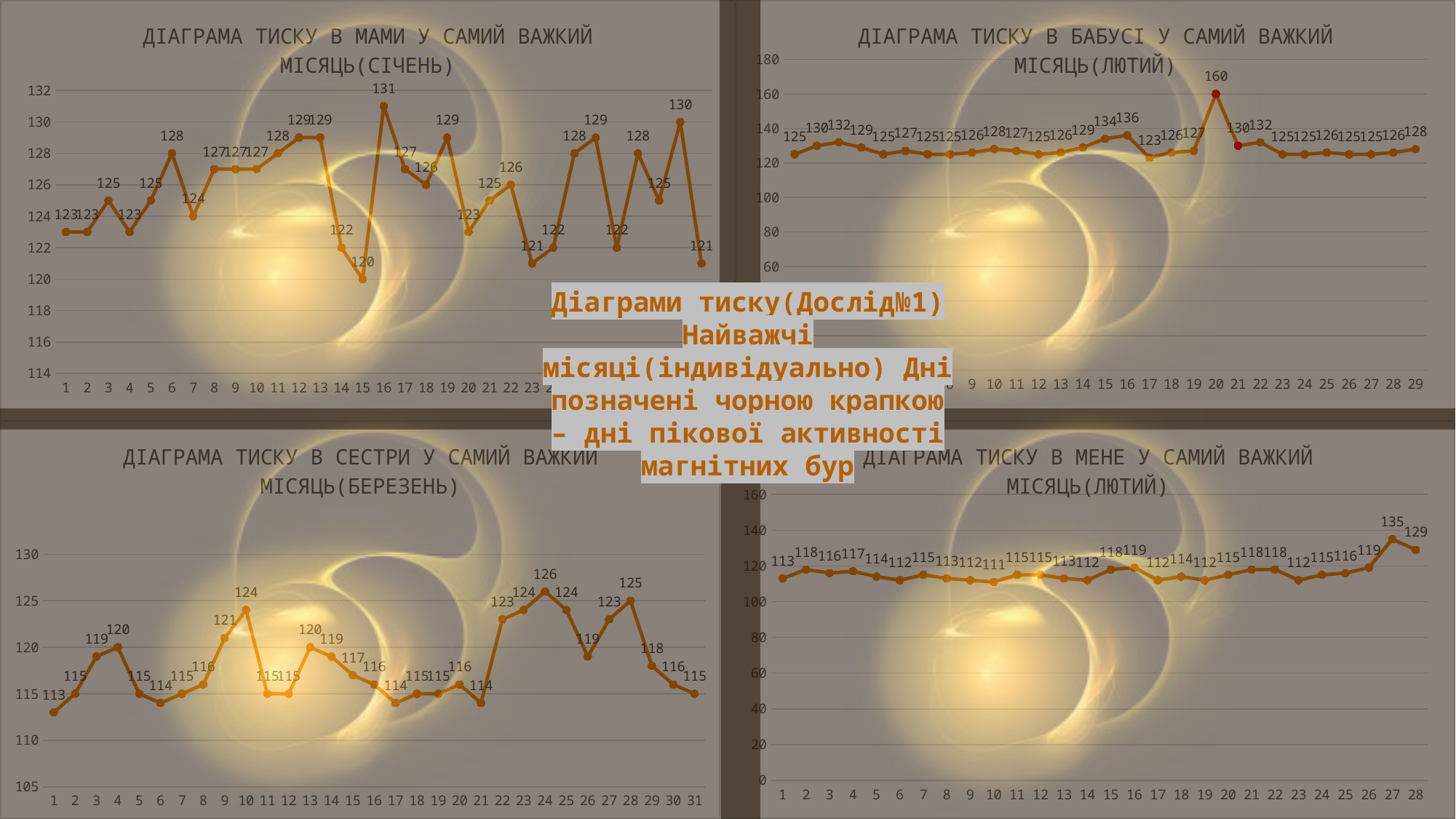
In the bottom-right chart (me, February), what is the lowest value? 111 In the top-right chart (grandmother, February), what is the difference between the values on day 20 and day 21? 30 In the top-left chart (mother, January), what is the value on day 16? 131 In the bottom-right chart (me, February), what is the value on day 27? 135 In the top-right chart (grandmother, February), what is the value on day 17? 123 What type of chart is used in the top-left chart (mother, January)? line chart In the top-left chart (mother, January), on which day is the lowest value recorded? 15 In the bottom-left chart (sister, March), which is larger: the value on day 10 or the value on day 13? day 10 In the bottom-left chart (sister, March), what is the value on day 1? 113 In the top-right chart (grandmother, February), what is the highest value and on which day does it occur? 160 on day 20 In the bottom-left chart (sister, March), what is the highest value? 126 How many days are plotted in the bottom-right chart (me, February)? 28